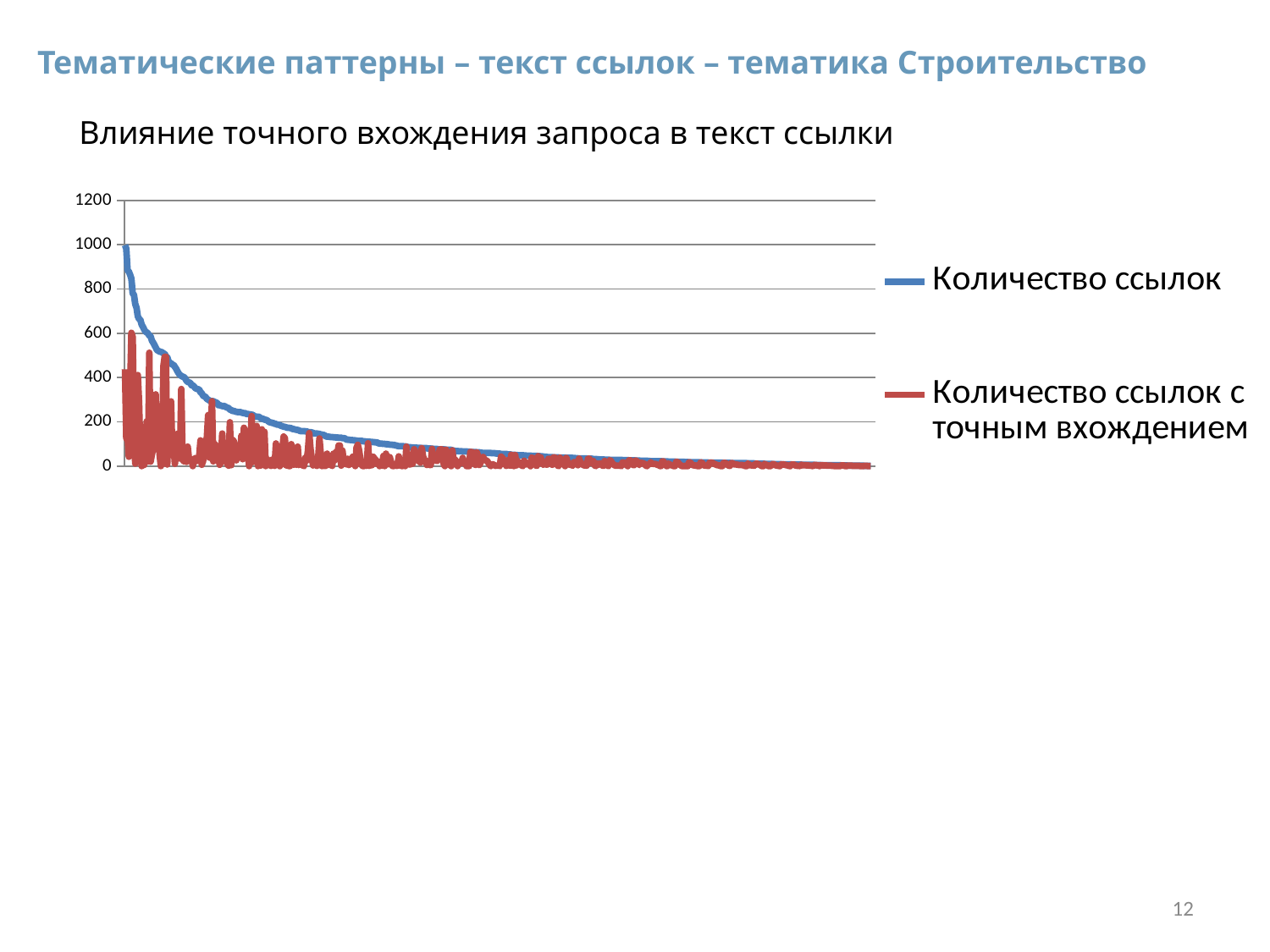
What is the second series listed in the legend? Количество ссылок с точным вхождением Is the value of the 'Количество ссылок' series at the right end of the chart greater or less than 200? less Is the highest value of the 'Количество ссылок с точным вхождением' series greater or less than 800? less What is the maximum value shown on the vertical axis? 1200 How many series does the legend list? 2 Is the highest value of the 'Количество ссылок с точным вхождением' series greater or less than 400? greater What is the first series listed in the legend? Количество ссылок Does the 'Количество ссылок' series rise or fall along the x axis? fall What kind of chart is shown on the slide? line chart Which series reaches the higher peak value, 'Количество ссылок' or 'Количество ссылок с точным вхождением'? Количество ссылок